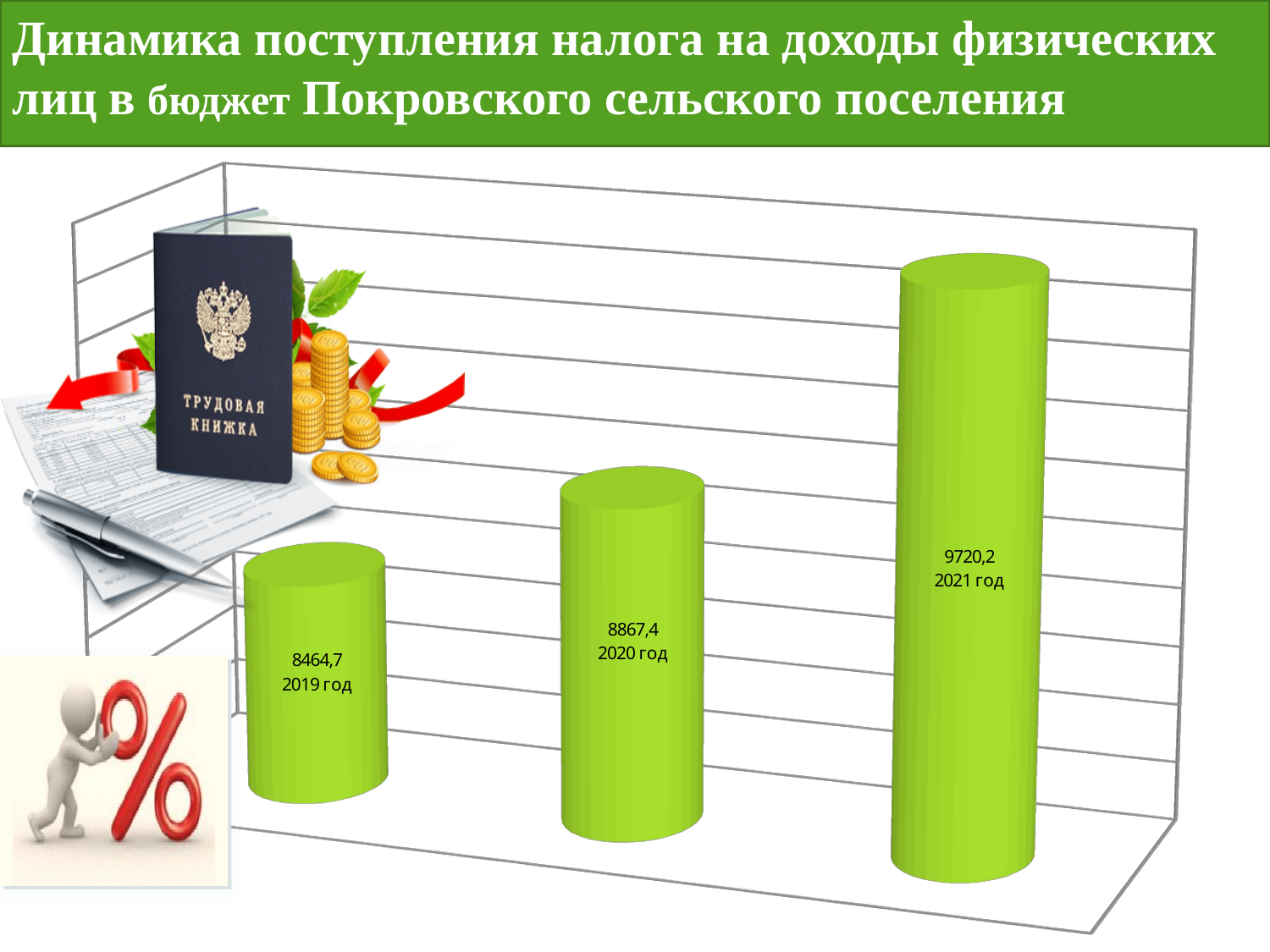
How many years (bars) are shown in the chart? 3 What is the difference between the values for 2020 год and 2019 год? 402,7 What is the difference between the values for 2021 год and 2020 год? 852,8 What is the difference between the values for 2021 год and 2019 год? 1255,5 What is the value for 2019 год? 8464,7 What is the value for 2020 год? 8867,4 Which year has the lowest value? 2019 год What is the value for 2021 год? 9720,2 Do the values rise or fall from 2019 год to 2021 год? rise Which year has the highest value? 2021 год What kind of chart is shown on the slide? bar chart Which is larger, the value for 2020 год or the value for 2019 год? 2020 год